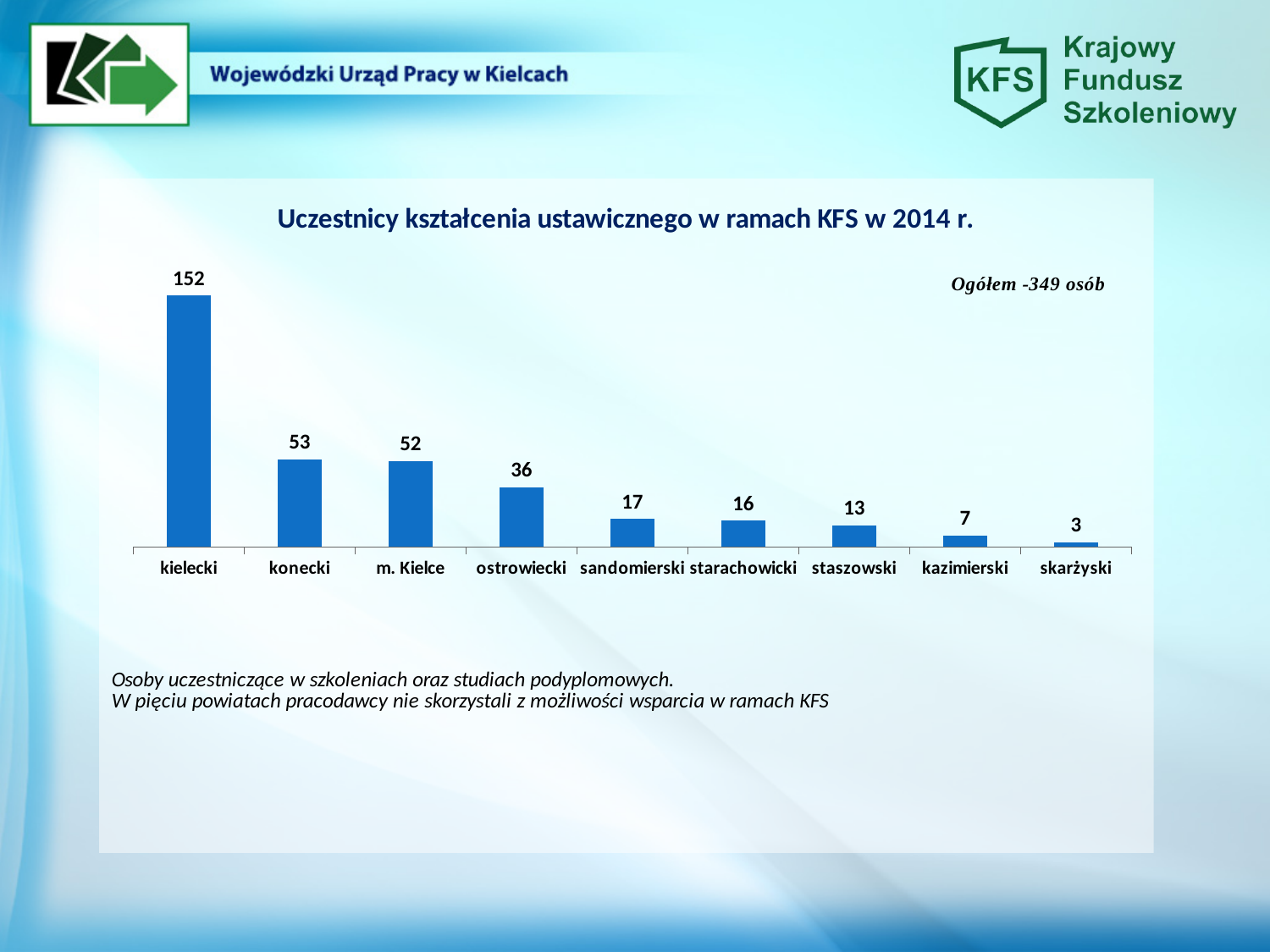
What is the value for staszowski? 13 Which category has the lowest value? skarżyski How many categories are shown on the x axis? 9 What is the value for ostrowiecki? 36 What kind of chart is this? bar chart What is the title of the chart? Uczestnicy kształcenia ustawicznego w ramach KFS w 2014 r. Which is larger, the value for ostrowiecki or the value for starachowicki? ostrowiecki What is the difference between the values for sandomierski and kazimierski? 10 What is the value for kielecki? 152 Which category has the highest value? kielecki Do the values rise or fall from left to right along the x axis? fall What is the difference between the values for kielecki and konecki? 99